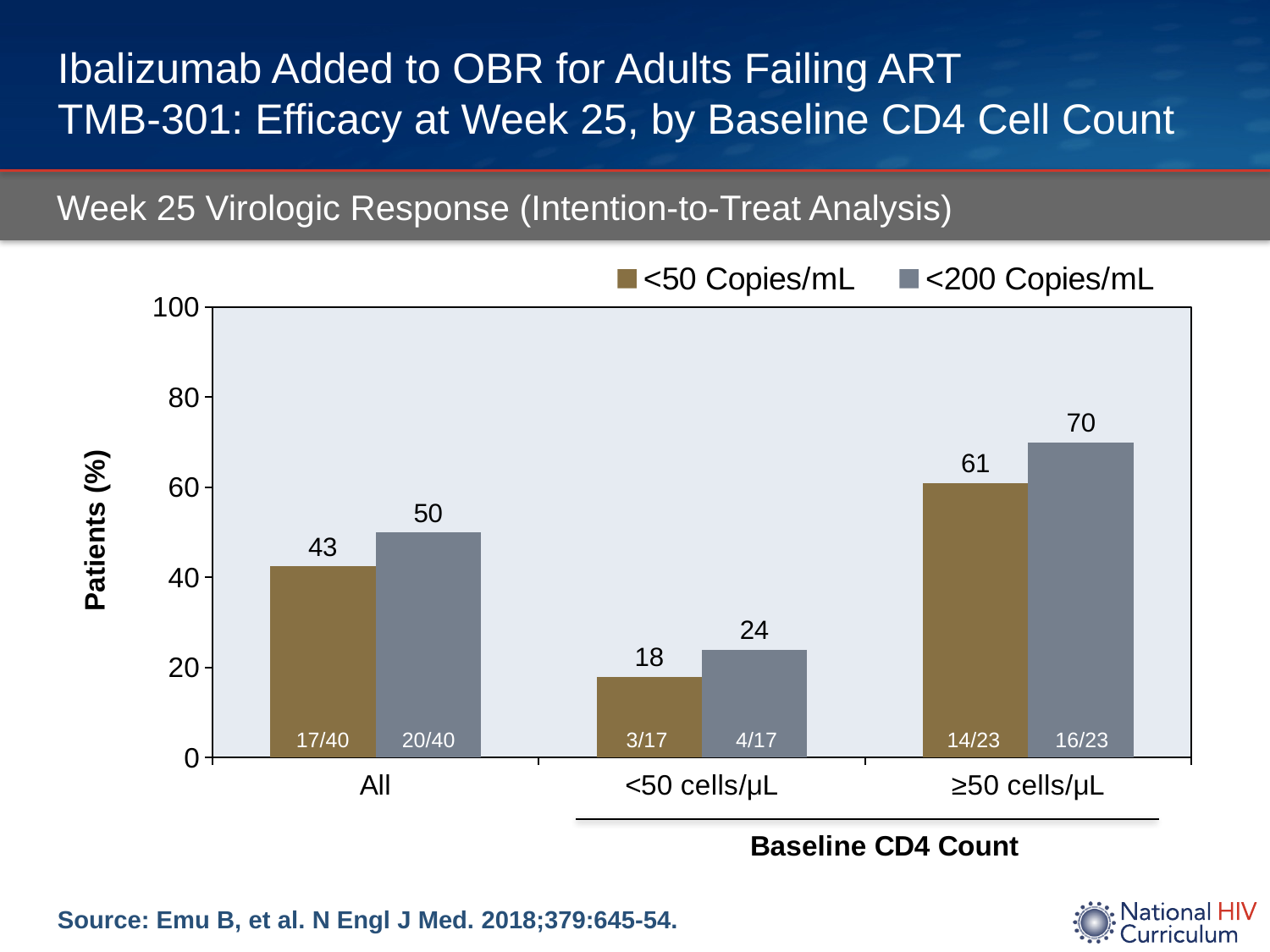
How many categories are shown on the x axis? 3 What is the difference in percentage points between the <50 copies/mL values for the ≥50 cells/µL group and the <50 cells/µL group? 43 What fraction of patients is printed on the <200 copies/mL bar for the <50 cells/µL group? 4/17 What is the difference in percentage points between the <200 copies/mL and <50 copies/mL bars for the ≥50 cells/µL group? 9 Which baseline CD4 category has the highest percentage of patients with <200 copies/mL? ≥50 cells/µL How many series does the legend list? 2 What kind of chart is shown on the slide? Bar chart Which category has the lowest percentage of patients with <50 copies/mL? <50 cells/µL What percentage of patients with baseline CD4 <50 cells/µL achieved <50 copies/mL? 18 What percentage of patients in the All group achieved <50 copies/mL? 43 What percentage of patients with baseline CD4 ≥50 cells/µL achieved <200 copies/mL? 70 Which is larger: the <200 copies/mL value for the All group or the <50 copies/mL value for the ≥50 cells/µL group? <50 copies/mL value for ≥50 cells/µL